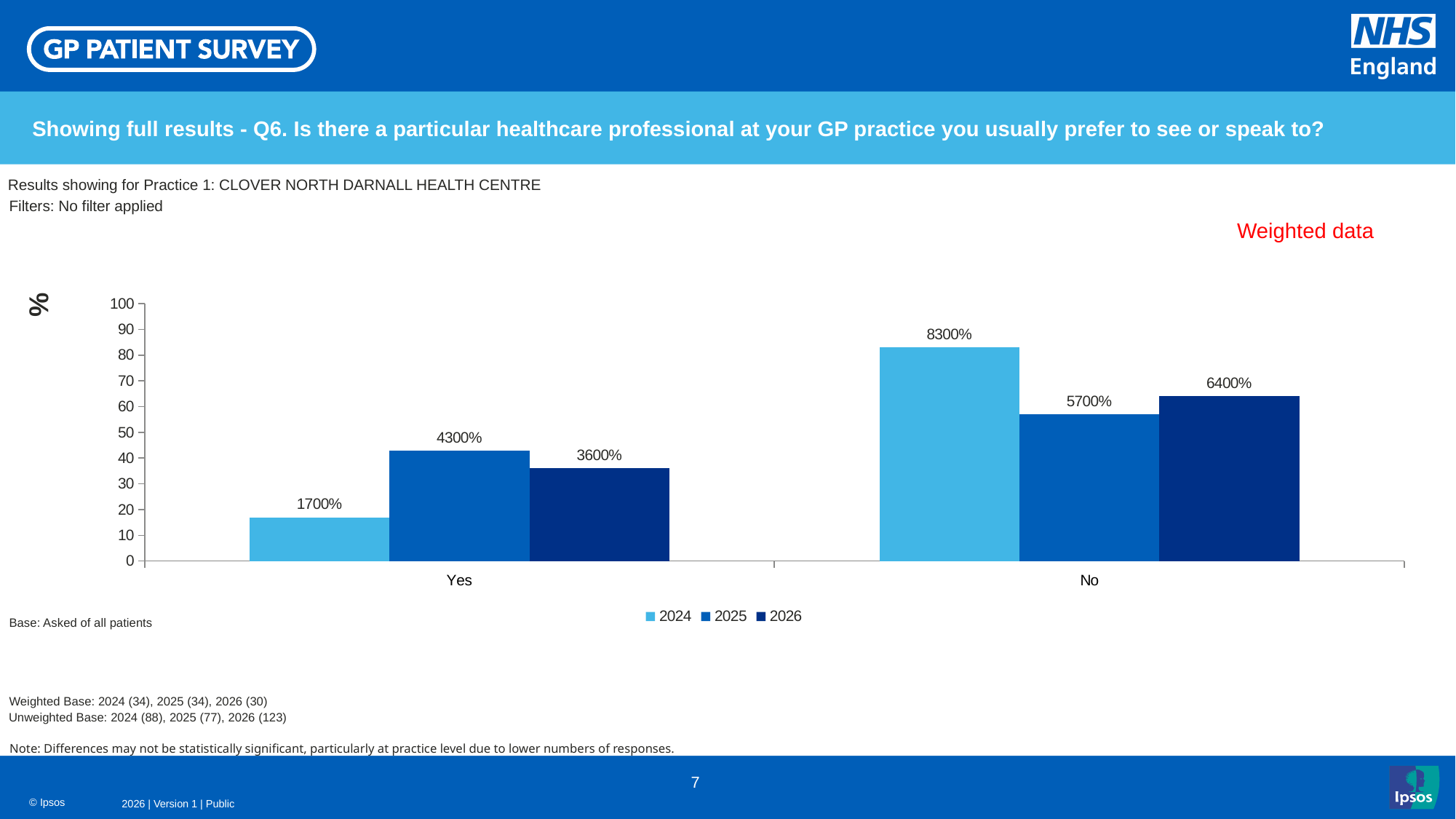
Which year has the lowest value in the Yes category? 2024 What kind of chart is shown on the slide? bar chart How many series does the legend list? 3 What is the value for 2025 in the No category? 5700% What is the value for 2024 in the No category? 8300% How many categories are shown on the x axis? 2 Which is larger: the 2025 value for Yes or the 2026 value for Yes? 2025 What is the value for 2026 in the Yes category? 3600% Which practice are the results shown for? CLOVER NORTH DARNALL HEALTH CENTRE Which year has the highest value in the No category? 2024 What is the difference between the 2026 value for No and the 2025 value for No? 700% What is the value for 2024 in the Yes category? 1700%